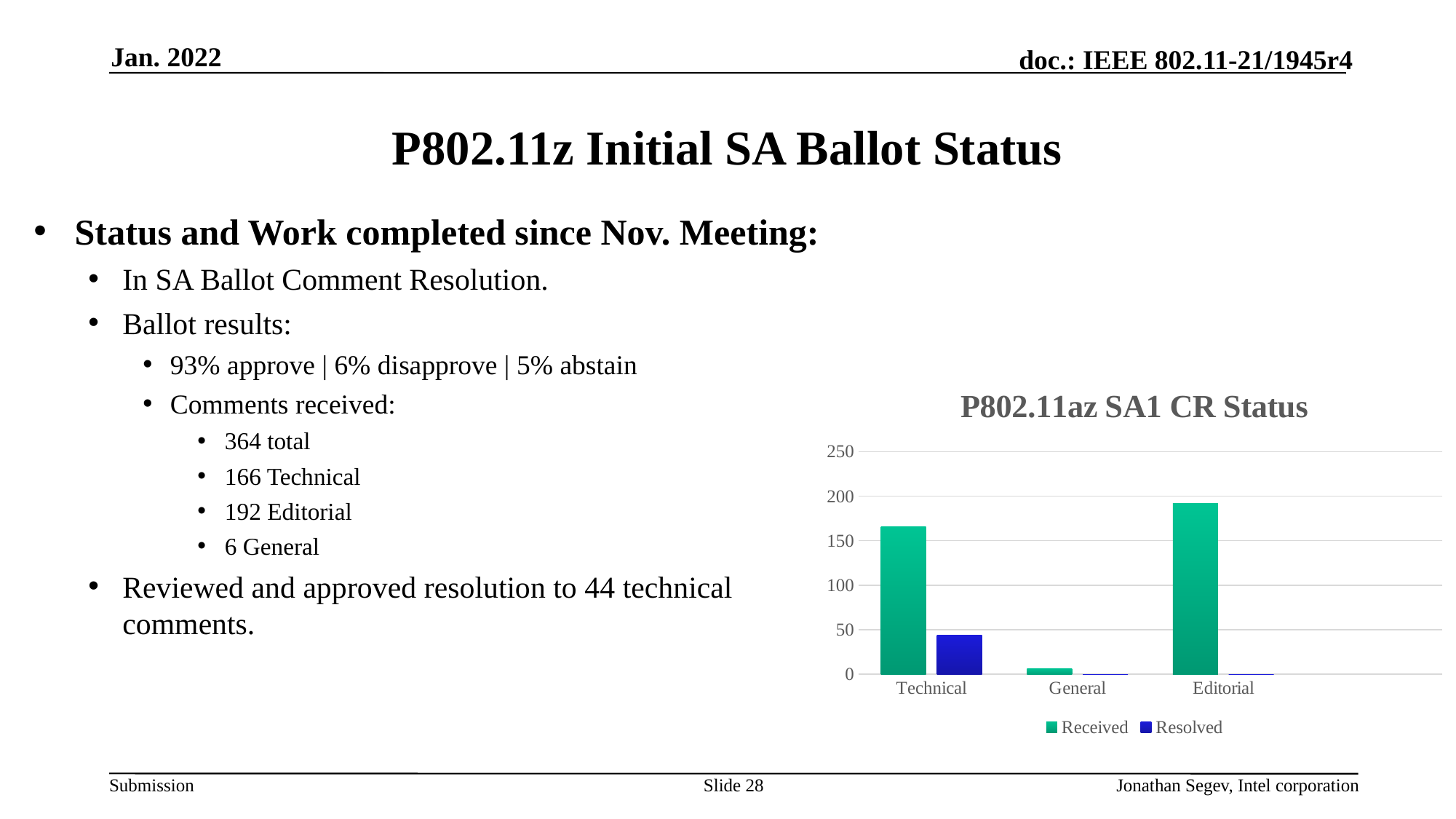
Which series is shown in blue in the chart? Resolved Which category has the lowest Received value? General Is the Received value for Editorial greater or less than 150? greater Is the Resolved value for Technical greater or less than 50? less What kind of chart is shown on the slide? bar chart Is the Received value for Technical greater or less than 200? less How many series does the chart legend list? 2 What is the title of the chart? P802.11az SA1 CR Status How many categories are shown on the x axis of the chart? 3 Which category has the highest Received value? Editorial Which category has the highest Resolved value? Technical Which is larger, the Received value for Technical or the Received value for Editorial? Editorial